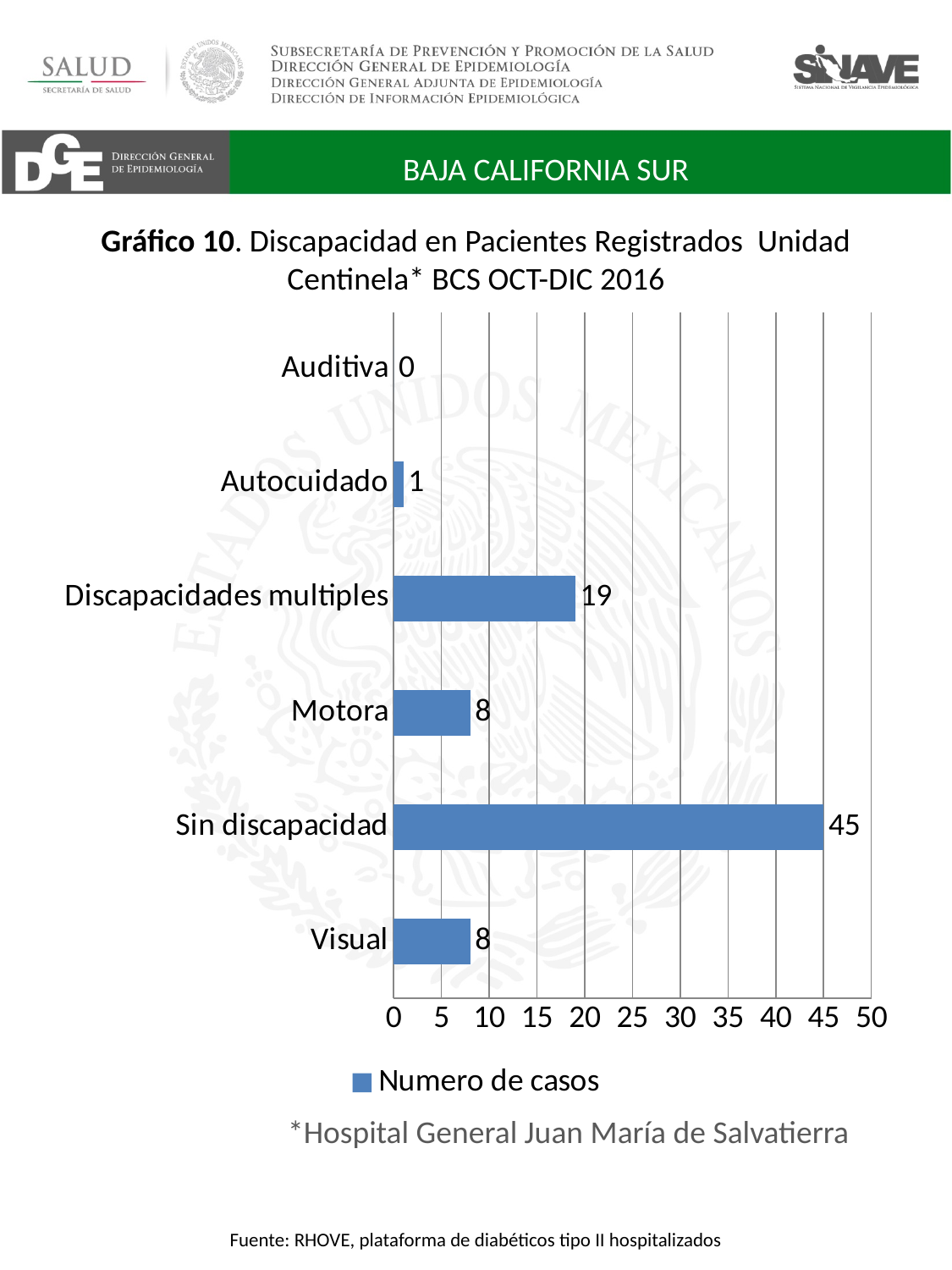
Which category has the highest value? Sin discapacidad What is the value for Discapacidades multiples? 19 What is the difference between the values for Sin discapacidad and Discapacidades multiples? 26 What is the value for Autocuidado? 1 Is the value for Sin discapacidad greater or less than 40? greater What kind of chart is shown on the slide? bar chart What series name does the legend show? Numero de casos Which category has the lowest value? Auditiva Which is larger, the value for Motora or the value for Discapacidades multiples? Discapacidades multiples How many categories are shown on the chart? 6 What is the value for Auditiva? 0 What is the value for Sin discapacidad? 45